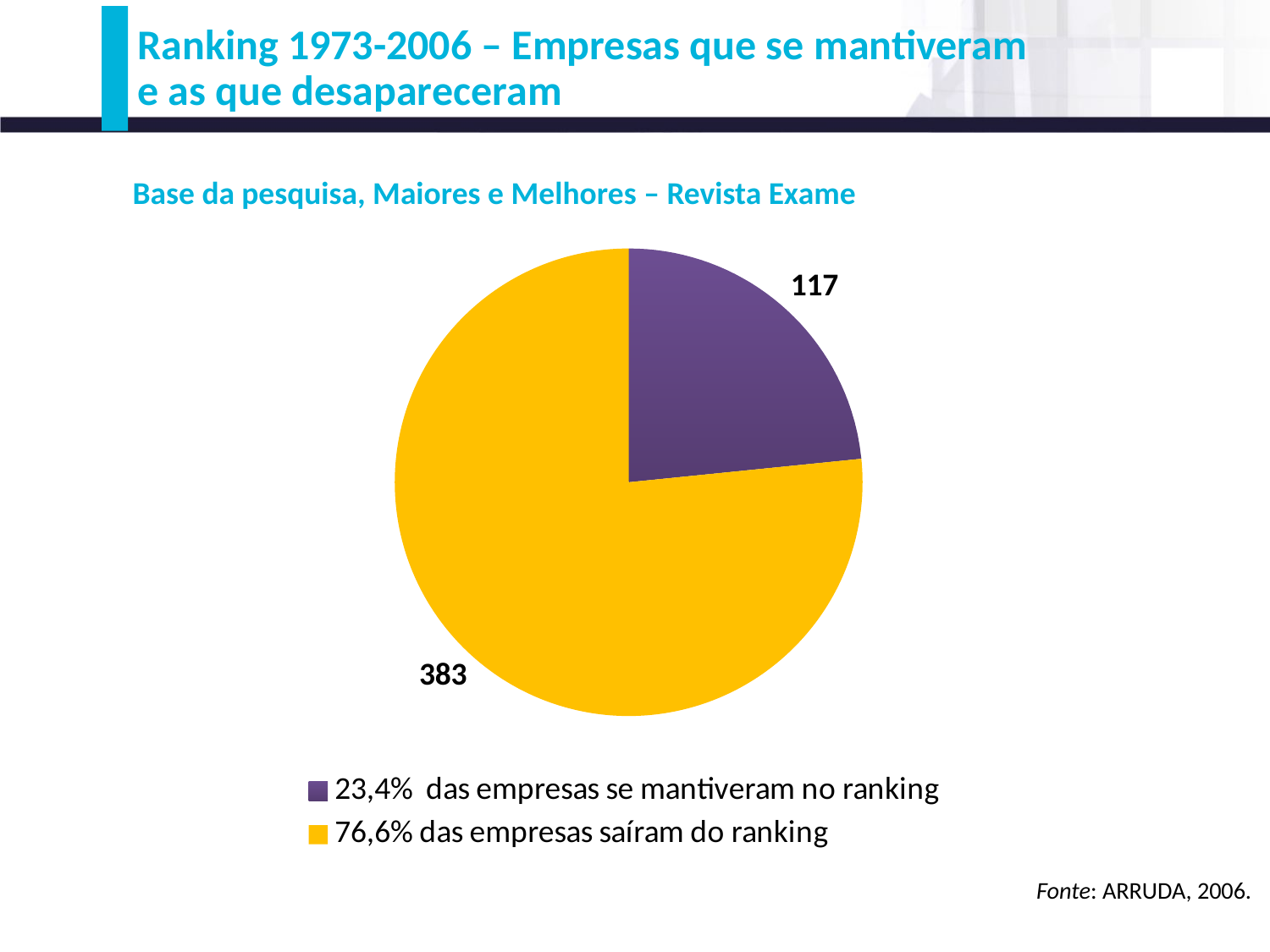
How many slices does the pie chart have? 2 What is the value of the slice for companies that remained in the ranking ("das empresas se mantiveram no ranking")? 117 What is the difference between the value of the slice for companies that left the ranking and the slice for companies that remained? 266 What is the value of the slice for companies that left the ranking ("das empresas saíram do ranking")? 383 Which is larger: the slice for companies that remained in the ranking or the slice for companies that left the ranking? das empresas saíram do ranking What kind of chart is shown on the slide? pie chart What share of the pie does the slice for companies that remained in the ranking represent, according to the legend? 23,4% What is the total of the two slices in the pie chart? 500 Which slice is the smallest? 23,4% das empresas se mantiveram no ranking How many entries does the legend list? 2 What colour is the slice for companies that left the ranking? yellow Which slice is the largest? 76,6% das empresas saíram do ranking